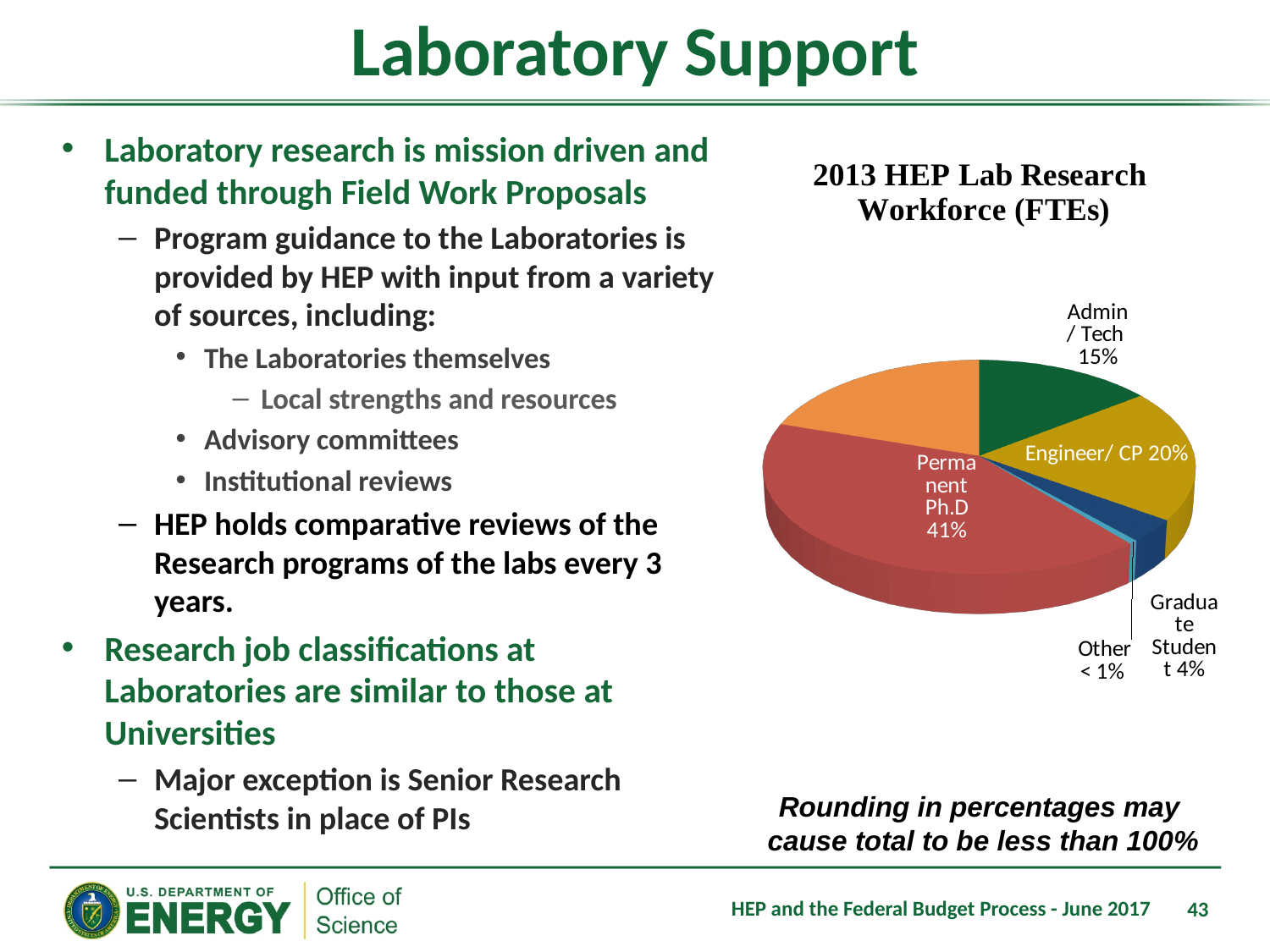
Which labeled category has the smallest share of the pie? Other What percentage of the workforce is Admin/Tech? 15% What share of the 2013 HEP Lab Research Workforce is Permanent Ph.D? 41% What share is shown for the Other category? < 1% How many percentage points larger is the Permanent Ph.D share than the Engineer/CP share? 21 percentage points Which labeled category has the largest share of the pie? Permanent Ph.D What percentage of the workforce is Engineer/CP? 20% What percentage of the workforce is Graduate Student? 4% What is the title of the chart? 2013 HEP Lab Research Workforce (FTEs) What kind of chart is shown on the slide? Pie chart Which is larger, the Engineer/CP share or the Admin/Tech share? Engineer/CP What note appears below the chart about the percentages? Rounding in percentages may cause total to be less than 100%